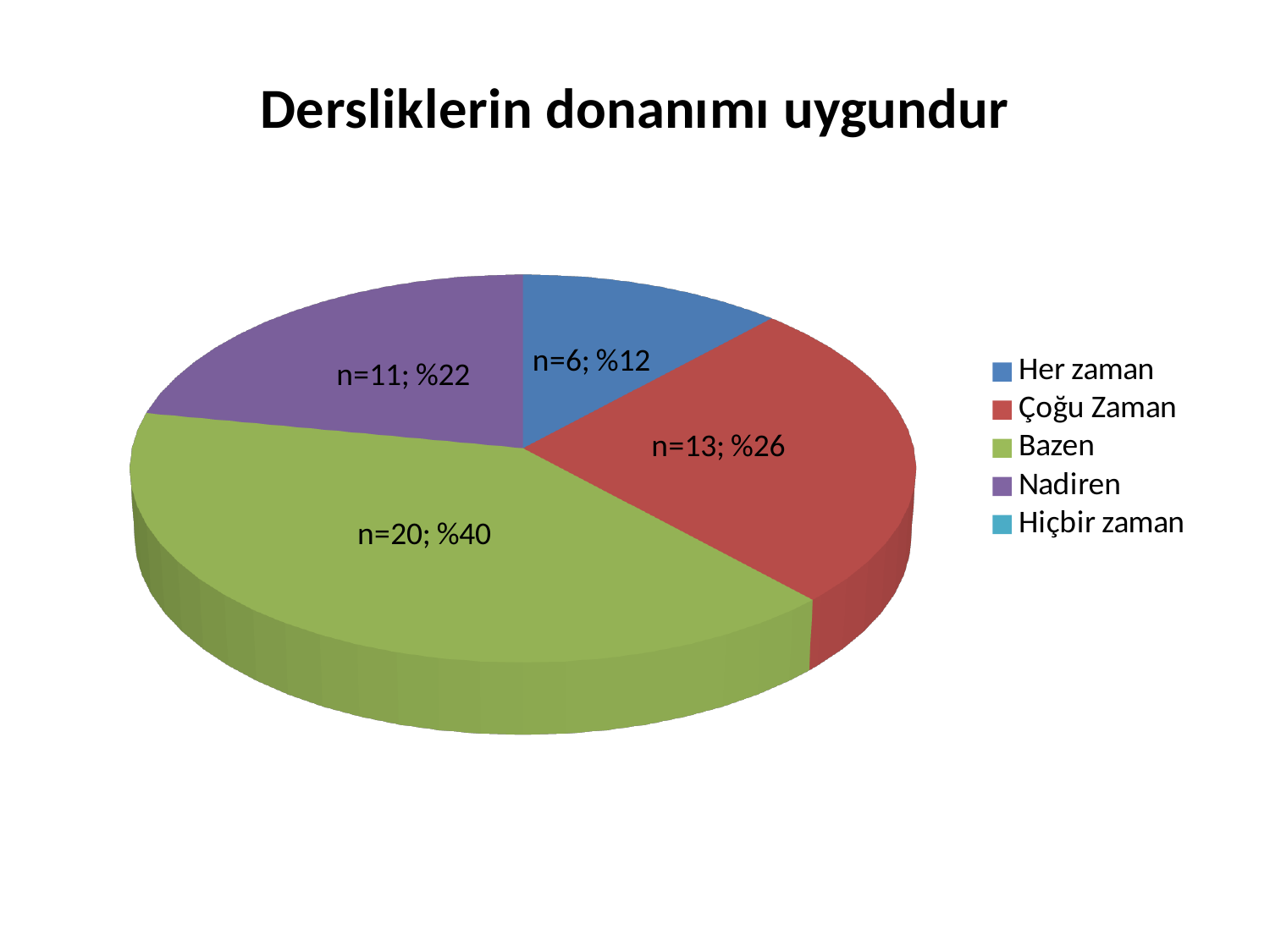
What colour is the Bazen slice? green What percentage share does the Nadiren slice have? %22 What is the n value for Çoğu Zaman? 13 What type of chart is shown on the slide? pie chart What percentage share does the Her zaman slice have? %12 Which visible slice of the pie is the smallest? Her zaman What is the data label for the Bazen slice? n=20; %40 Which category has the largest slice of the pie? Bazen What is the difference in n between Bazen and Her zaman? 14 What is the title of the chart? Dersliklerin donanımı uygundur How many entries does the legend list? 5 Which is larger, the Çoğu Zaman slice or the Nadiren slice? Çoğu Zaman